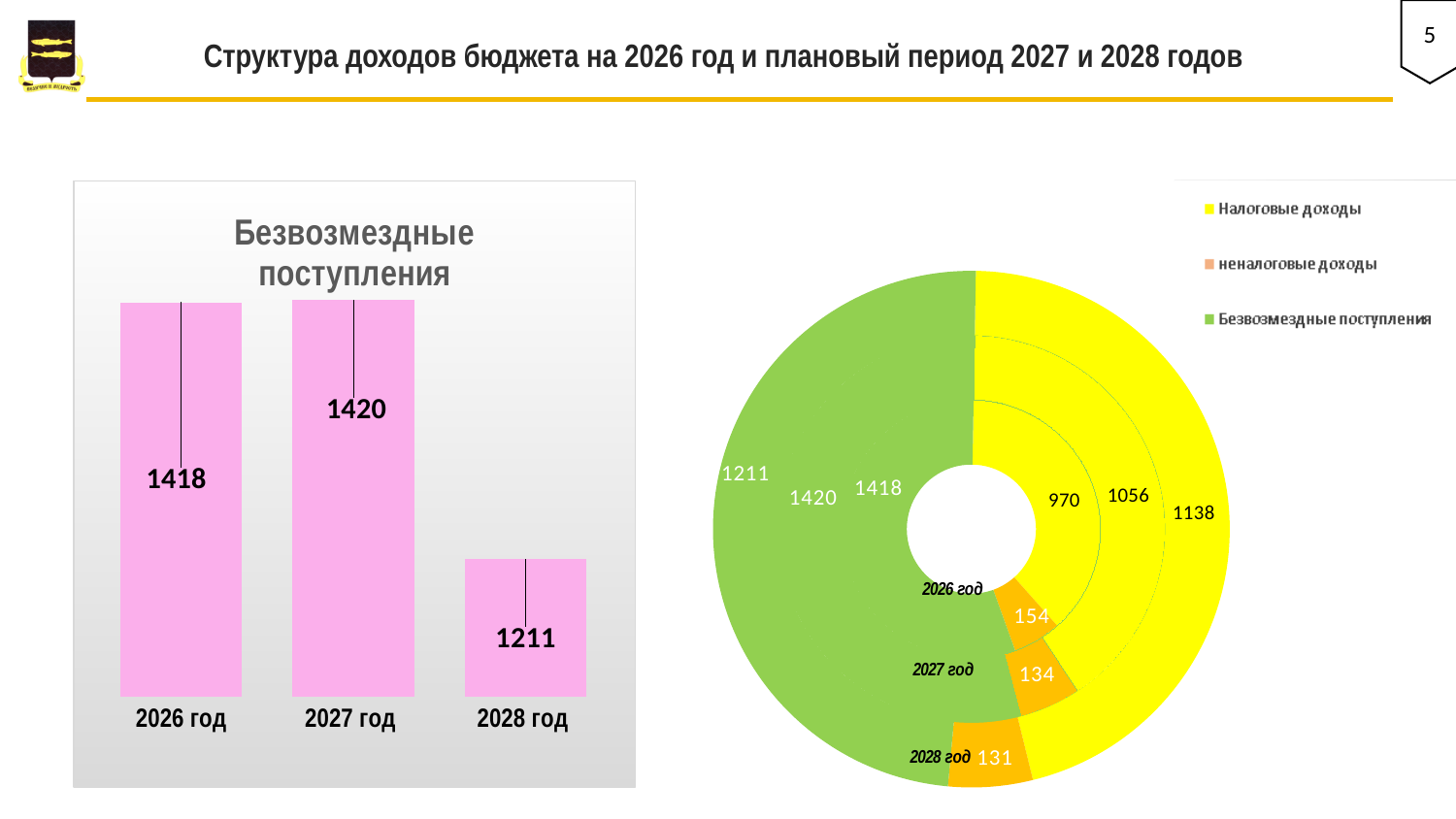
What kind of chart is the chart on the right side of the slide? doughnut chart On the doughnut chart on the right, do the values of Налоговые доходы rise or fall from 2026 год to 2028 год? rise On the bar chart titled 'Безвозмездные поступления', what is the difference between the values for 2027 год and 2028 год? 209 On the doughnut chart on the right, what is the total of the three values for 2026 год? 2542 On the doughnut chart on the right, which is larger for 2027 год: Налоговые доходы or неналоговые доходы? Налоговые доходы On the bar chart titled 'Безвозмездные поступления', which year has the lowest value? 2028 год On the bar chart titled 'Безвозмездные поступления', what is the value for 2027 год? 1420 On the doughnut chart on the right, what is the value of неналоговые доходы for 2028 год? 131 On the doughnut chart on the right, how many series does the legend list? 3 On the bar chart titled 'Безвозмездные поступления', how many years are shown? 3 What kind of chart is the chart on the left side of the slide? bar chart On the doughnut chart on the right, what is the value of Налоговые доходы for 2026 год? 970